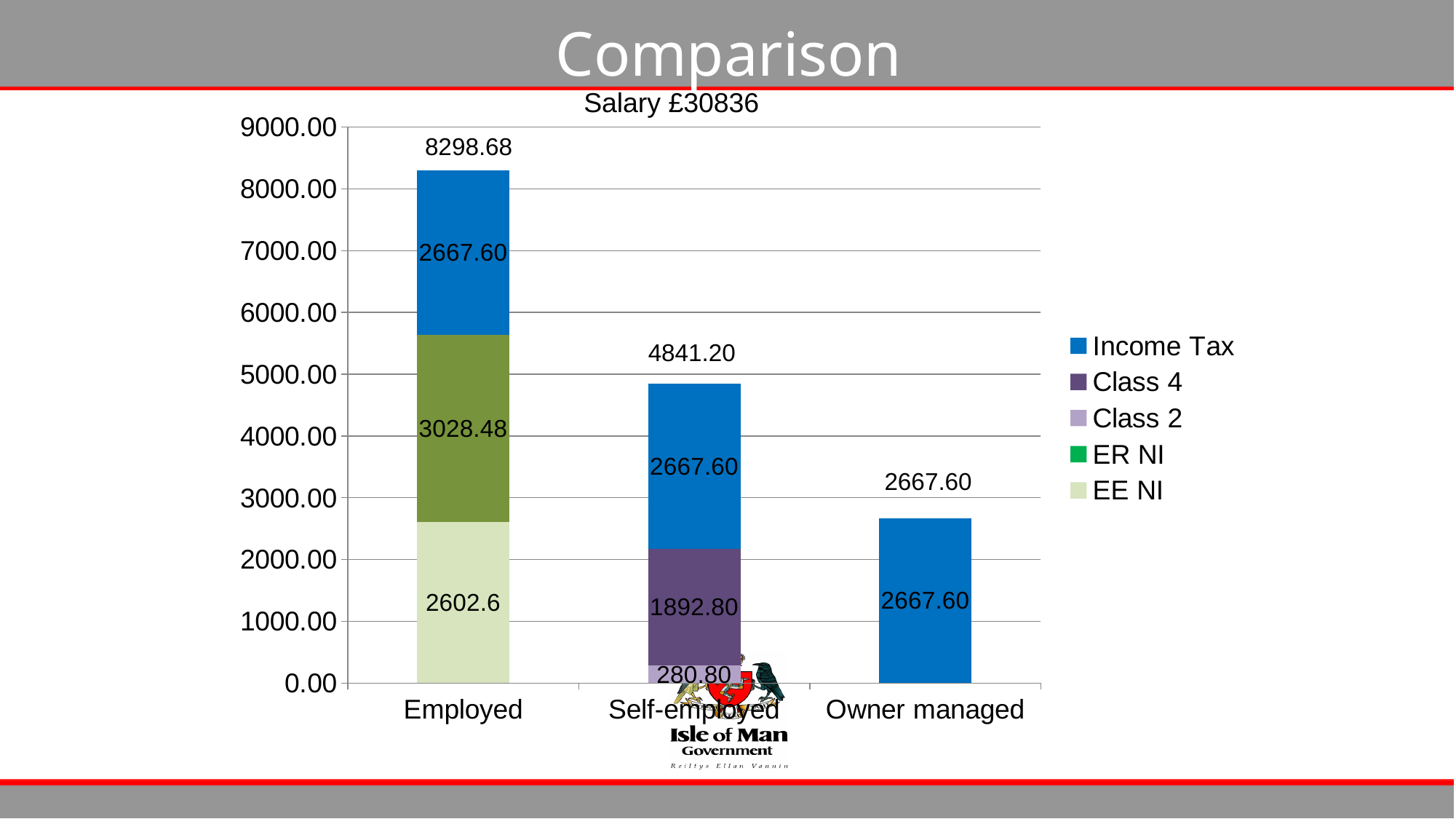
What is the Class 2 value for Self-employed? 280.80 What is the Class 4 value for Self-employed? 1892.80 How many series does the legend list? 5 What is the total of the Self-employed bar? 4841.20 What is the difference between the Employed total and the Self-employed total? 3457.48 What kind of chart is shown on the slide? Stacked bar chart What is the total of the Employed bar? 8298.68 Which category has the highest total bar? Employed What is the title of the chart? Salary £30836 What is the Income Tax value for Owner managed? 2667.60 Which category has the lowest total bar? Owner managed What is the EE NI value for Employed? 2602.6